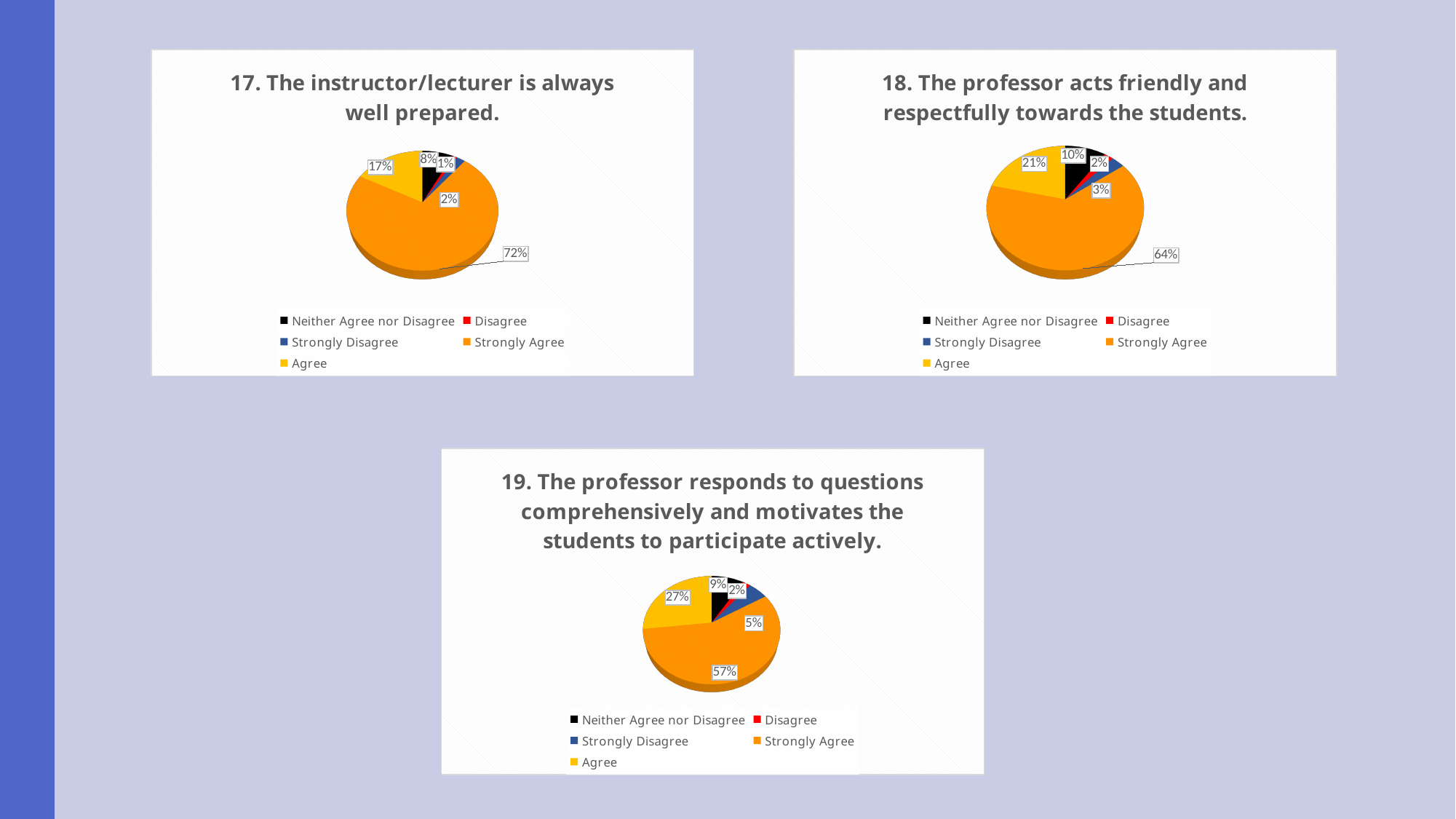
In the chart titled "17. The instructor/lecturer is always well prepared.", which category has the smallest share? Disagree In the chart titled "19. The professor responds to questions comprehensively and motivates the students to participate actively.", what percentage is Strongly Disagree? 5% How many categories does the legend list in the chart titled "18. The professor acts friendly and respectfully towards the students."? 5 In the chart titled "17. The instructor/lecturer is always well prepared.", which category has the largest share? Strongly Agree In the chart titled "18. The professor acts friendly and respectfully towards the students.", what percentage is Neither Agree nor Disagree? 10% In the chart titled "18. The professor acts friendly and respectfully towards the students.", what percentage is Strongly Agree? 64% In the chart titled "19. The professor responds to questions comprehensively and motivates the students to participate actively.", which is larger, Neither Agree nor Disagree or Strongly Disagree? Neither Agree nor Disagree In the chart titled "17. The instructor/lecturer is always well prepared.", what percentage is Strongly Agree? 72% In the chart titled "19. The professor responds to questions comprehensively and motivates the students to participate actively.", what percentage is Agree? 27% What type of chart is used for the chart titled "19. The professor responds to questions comprehensively and motivates the students to participate actively."? Pie chart In the chart titled "17. The instructor/lecturer is always well prepared.", what percentage is Agree? 17% In the chart titled "18. The professor acts friendly and respectfully towards the students.", what is the difference between the Strongly Agree and Agree shares? 43%